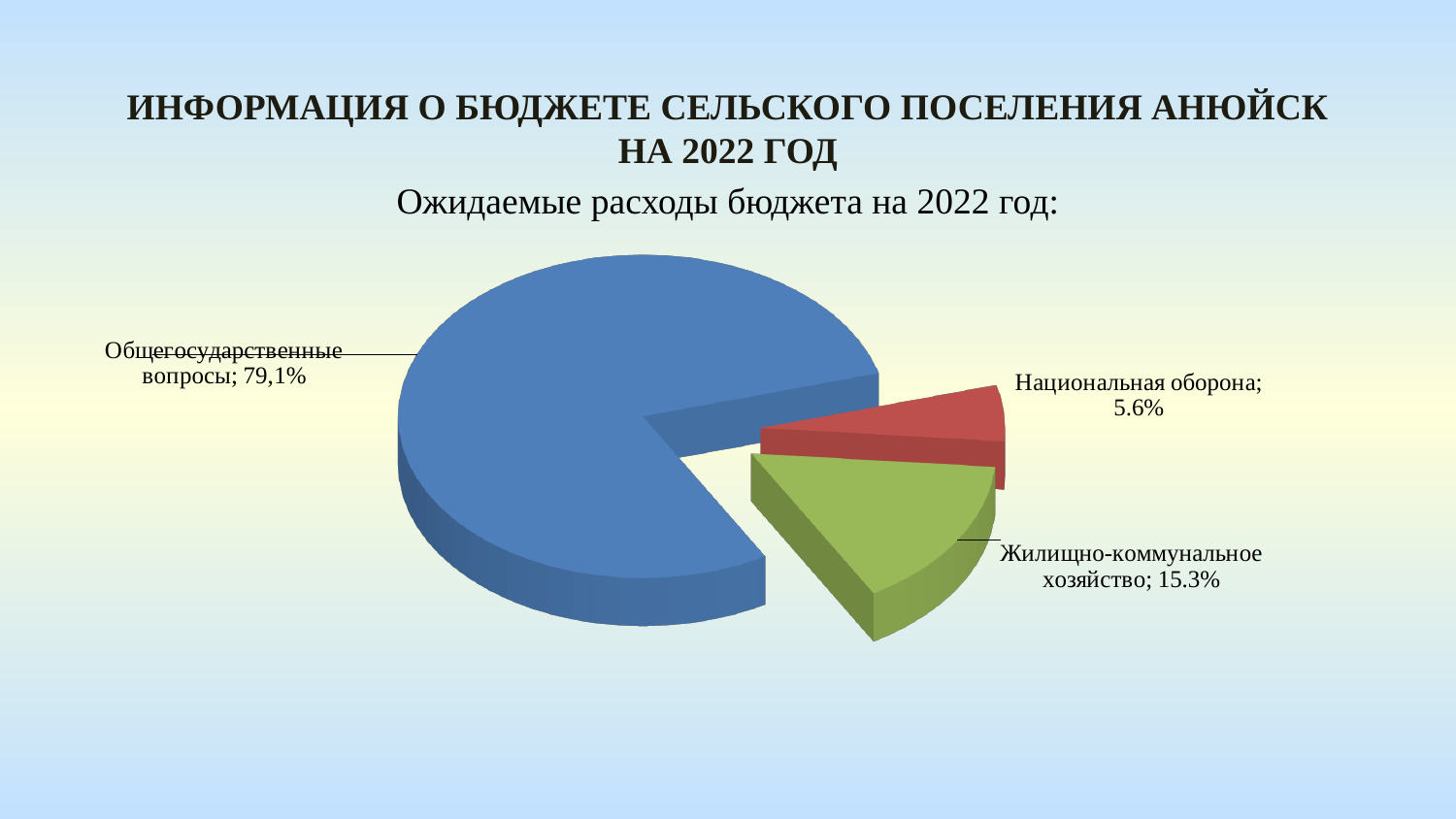
Which is larger: the slice for Жилищно-коммунальное хозяйство or the slice for Национальная оборона? Жилищно-коммунальное хозяйство What share of the pie is labelled for Общегосударственные вопросы? 79,1% What share of the pie is labelled for Национальная оборона? 5.6% What kind of chart is shown on the slide? pie chart Which category has the smallest slice of the pie? Национальная оборона What is the subtitle shown above the pie chart? Ожидаемые расходы бюджета на 2022 год: What colour is the slice for Национальная оборона? red What is the difference in percentage points between Жилищно-коммунальное хозяйство and Национальная оборона? 9.7 Which category has the largest slice of the pie? Общегосударственные вопросы How many slices does the pie chart have? 3 What share of the pie is labelled for Жилищно-коммунальное хозяйство? 15.3%